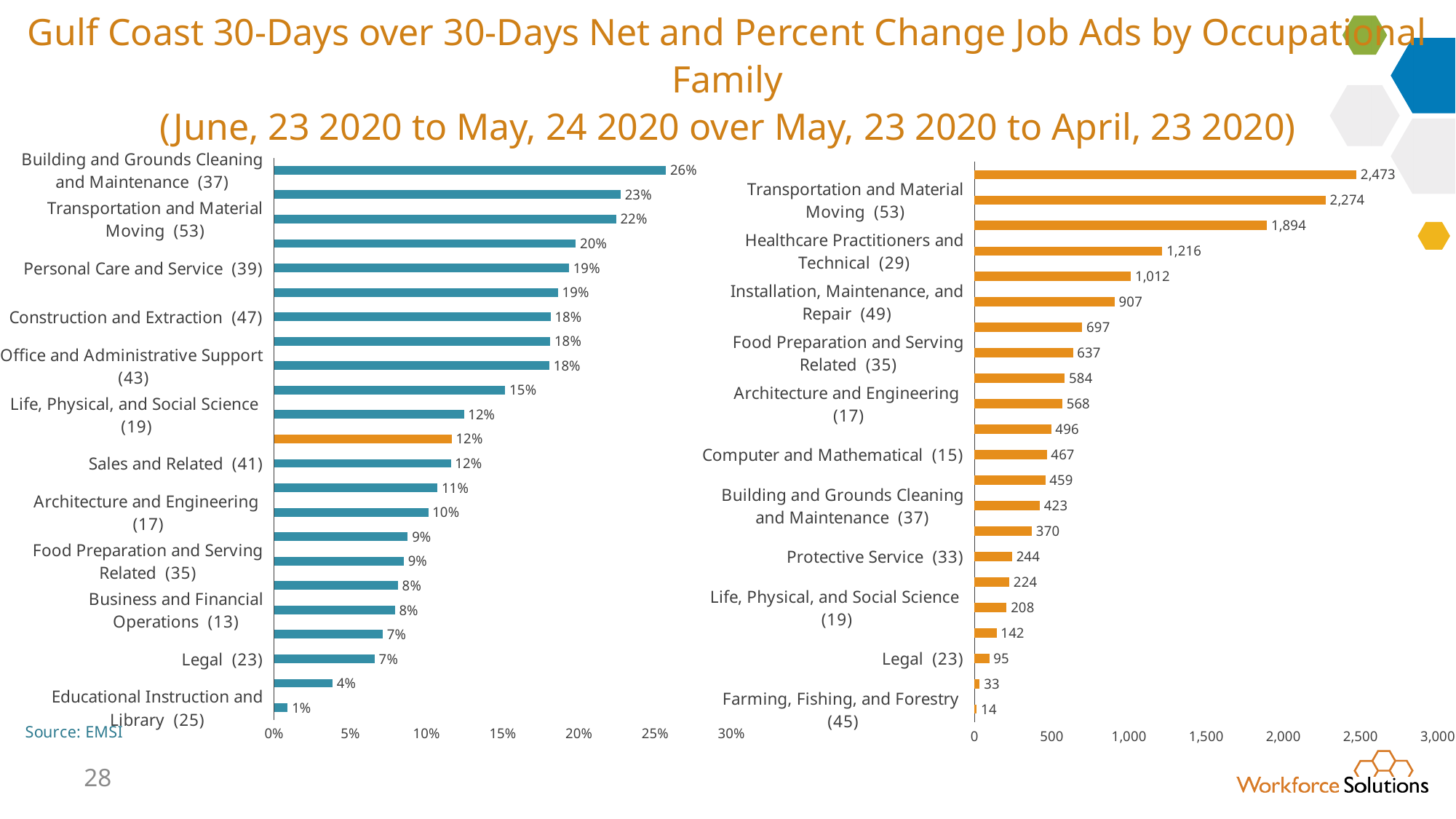
On the right chart (net change), which is larger: Installation, Maintenance, and Repair (49) or Protective Service (33)? Installation, Maintenance, and Repair (49) On the right chart (net change), what is the value for Legal (23)? 95 On the left chart (percent change), what is the value for Transportation and Material Moving (53)? 22% On the right chart (net change), what is the value for Healthcare Practitioners and Technical (29)? 1,216 On the right chart (net change), which occupational family has the lowest value? Farming, Fishing, and Forestry (45) On the left chart (percent change), which occupational family has the highest value? Building and Grounds Cleaning and Maintenance (37) On the right chart (net change), what is the largest value shown? 2,473 On the right chart (net change), what is the difference between Transportation and Material Moving (53) and Healthcare Practitioners and Technical (29)? 1,058 What kind of chart is used on the right side of the slide? Bar chart What source is cited for the data on the slide? EMSI On the left chart (percent change), what is the difference between Transportation and Material Moving (53) and Legal (23)? 15 percentage points On the left chart (percent change), which occupational family has the lowest value? Educational Instruction and Library (25)